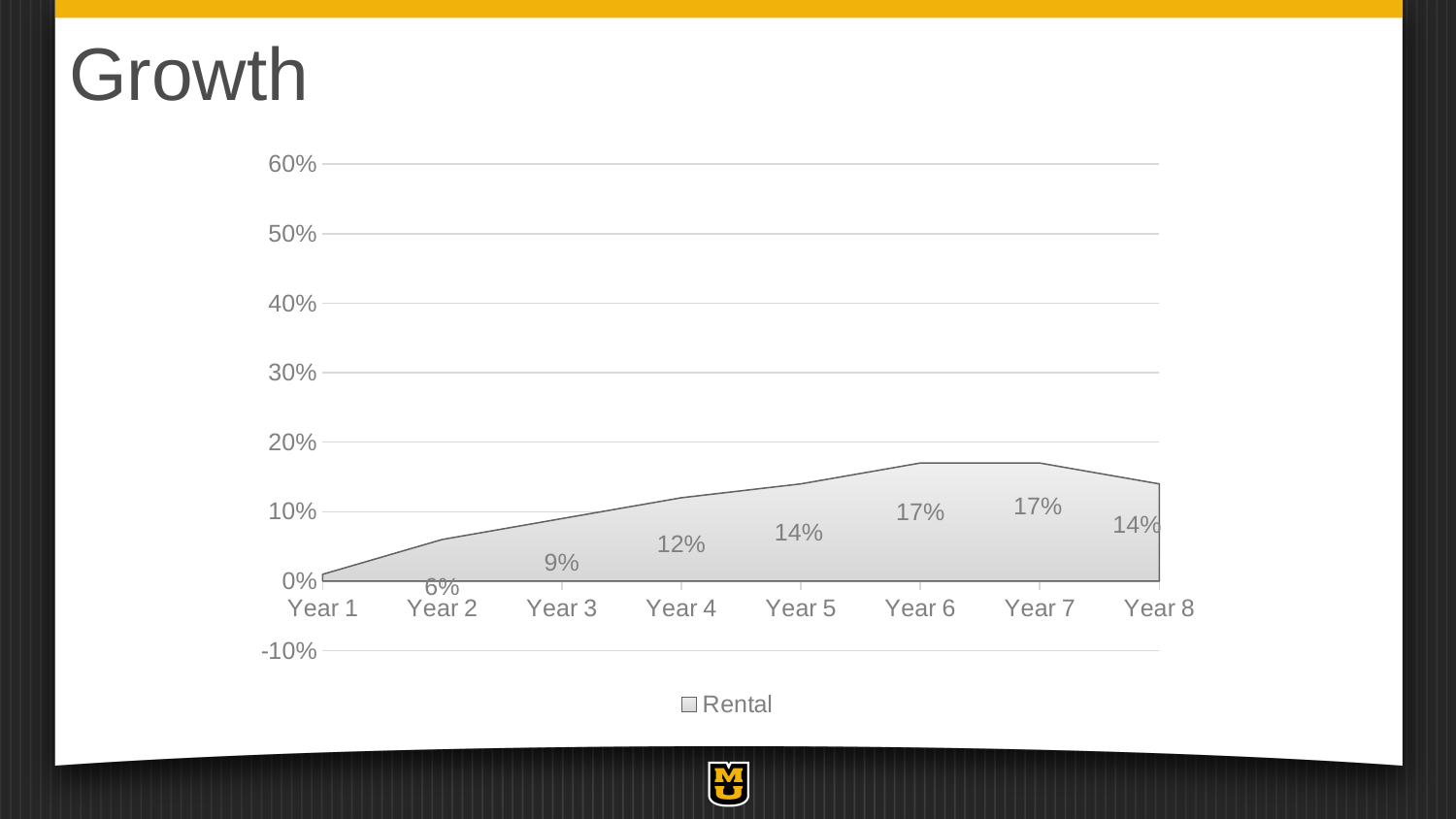
Which is larger, the Rental value for Year 7 or for Year 8? Year 7 What is the Rental value for Year 2? 6% Do the Rental values rise or fall from Year 1 to Year 6? rise What kind of chart is shown on the slide? Area chart How many years are shown on the x axis? 8 Is the Rental value for Year 5 greater or less than 20%? less Which year has the lowest Rental value? Year 1 What is the Rental value for Year 8? 14% What is the Rental value for Year 3? 9% How many series does the legend list? 1 What is the difference between the Rental values for Year 6 and Year 4? 5% What is the Rental value for Year 6? 17%